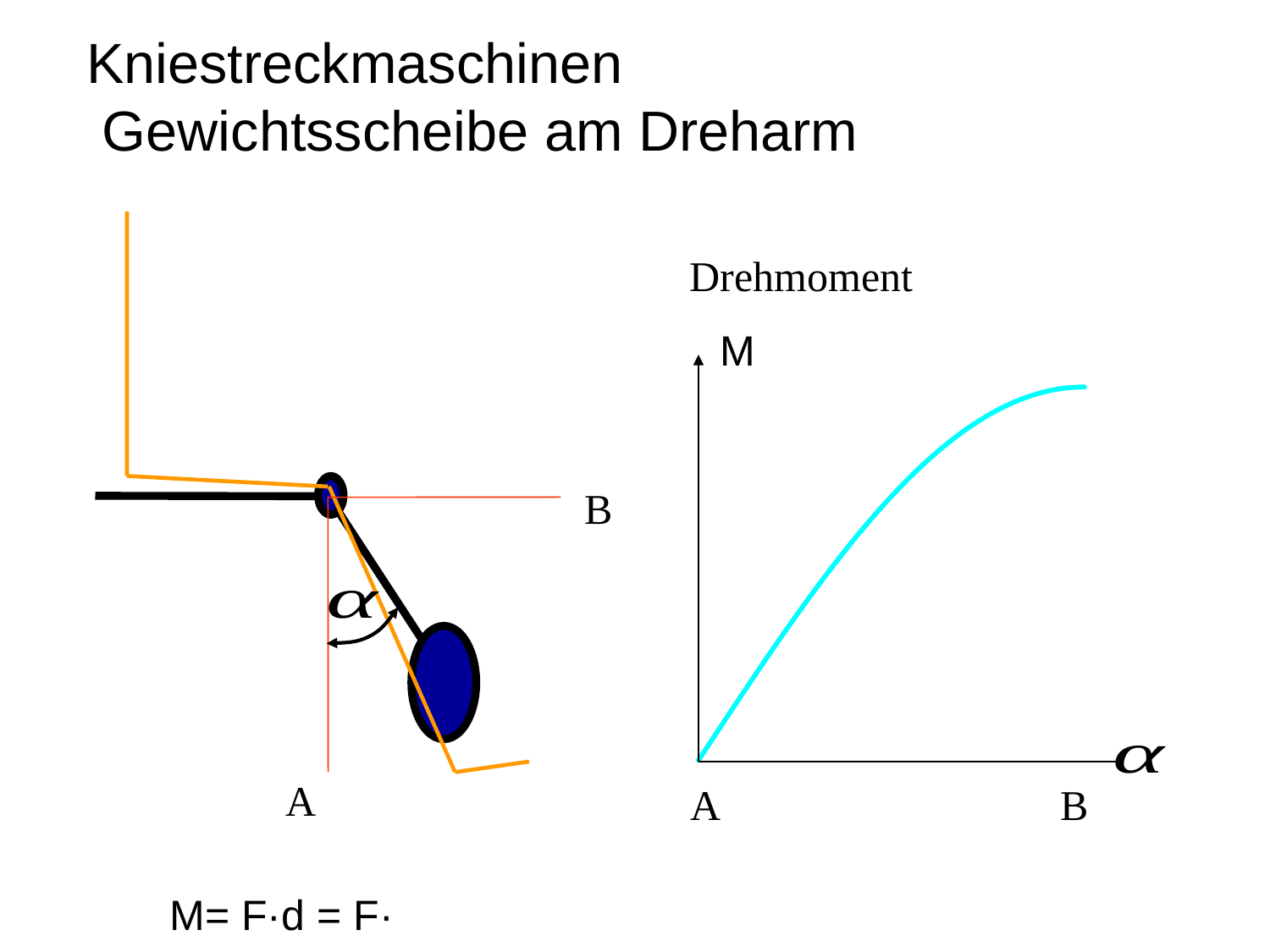
What label is on the horizontal axis of the Drehmoment chart? α How many curves are plotted in the Drehmoment chart? 1 In the Drehmoment chart, at which labelled point on the α axis, A or B, is M higher? B What label is on the vertical axis of the Drehmoment chart? M What kind of chart is shown on the right side of the slide? line chart In the Drehmoment chart, at which labelled point on the α axis is M lowest? A What is the title written above the chart on the right? Drehmoment In the Drehmoment chart, does the value of M rise or fall as α increases from A to B? rise In the Drehmoment chart, at which labelled point on the α axis is M highest? B